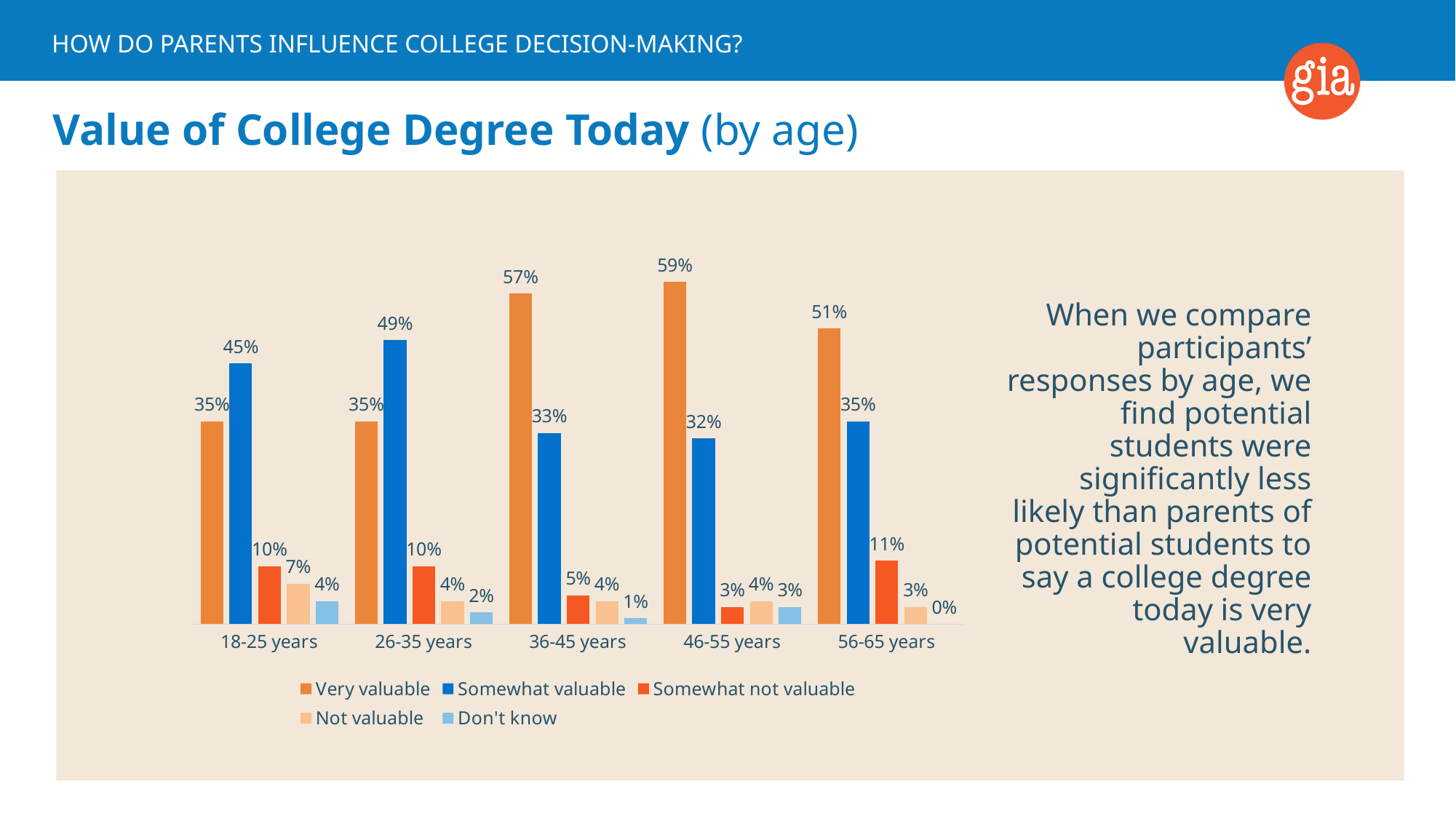
What percentage of 46-55 year olds said a college degree is very valuable? 59% What kind of chart is shown on the slide? Bar chart What is the 'Somewhat valuable' value for the 26-35 years group? 49% How many series does the legend list? 5 What is the 'Somewhat not valuable' value for the 56-65 years group? 11% Which is larger for the 18-25 years group: 'Very valuable' or 'Somewhat valuable'? Somewhat valuable Which colour represents 'Somewhat valuable' in the legend? Blue What is the 'Don't know' value for the 56-65 years group? 0% What is the difference between the 'Very valuable' values for 36-45 years and 18-25 years? 22% How many age groups are shown on the x axis? 5 Which age group has the lowest 'Somewhat valuable' percentage? 46-55 years Which age group has the highest 'Very valuable' percentage? 46-55 years